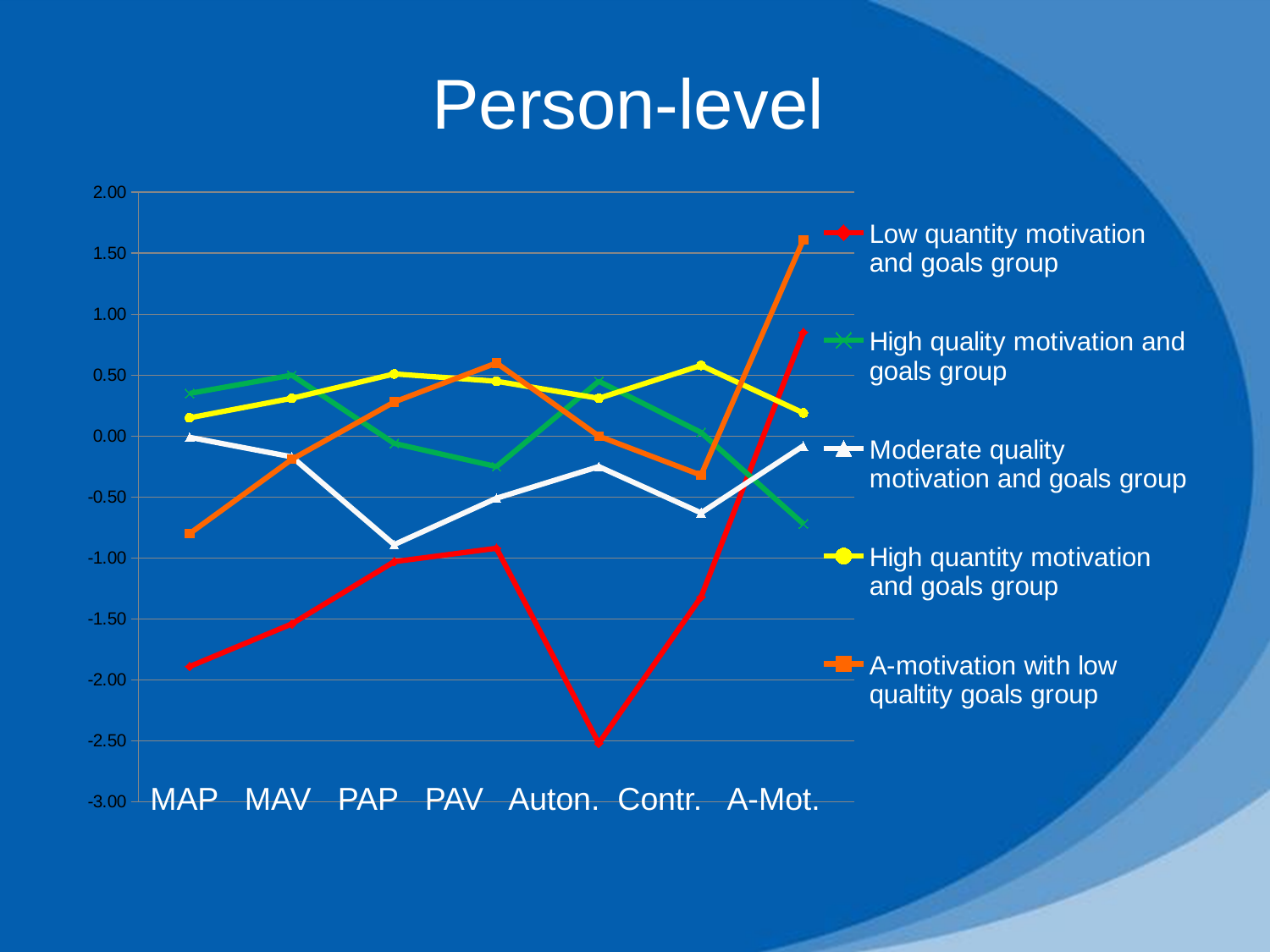
Is the value for the Low quantity motivation and goals group at MAP greater or less than -1.50? less Is the value for the A-motivation with low qualtity goals group at A-Mot. greater or less than 1.50? greater Is the value for the Low quantity motivation and goals group at Auton. greater or less than -2.00? less What kind of chart is shown on the slide? line chart What is the title of the slide containing the chart? Person-level At which category does the A-motivation with low qualtity goals group line reach its highest value? A-Mot. How many categories are shown along the x axis? 7 How many series does the legend list? 5 At which category does the Low quantity motivation and goals group line reach its highest value? A-Mot. At MAP, which series has the higher value: the Low quantity motivation and goals group or the High quality motivation and goals group? High quality motivation and goals group At which category does the Low quantity motivation and goals group line reach its lowest value? Auton. At A-Mot., which series has the higher value: the A-motivation with low qualtity goals group or the Low quantity motivation and goals group? A-motivation with low qualtity goals group